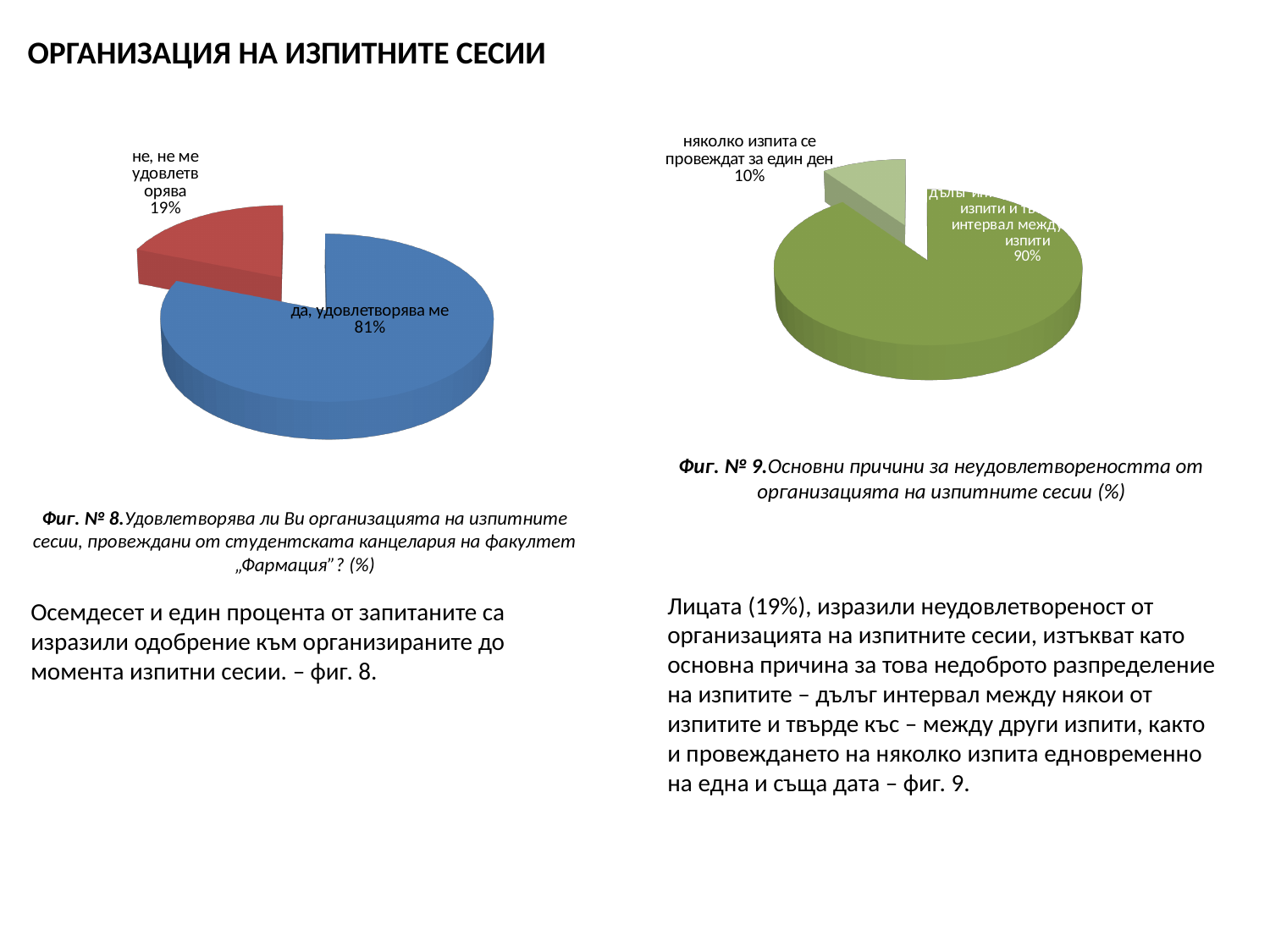
On the right chart (Фиг. № 9), is the share for "няколко изпита се провеждат за един ден" larger or smaller than the other slice? smaller On the right chart (Фиг. № 9), how many slices does the pie have? 2 On the right chart (Фиг. № 9), what is the share of the largest slice? 90% On the left chart (Фиг. № 8), how many slices does the pie have? 2 On the left chart (Фиг. № 8), what is the difference in percentage points between the "да, удовлетворява ме" and "не, не ме удовлетворява" slices? 62 On the left chart (Фиг. № 8), what percentage of respondents answered "да, удовлетворява ме"? 81% What type of chart is shown on the left (Фиг. № 8)? Pie chart On the left chart (Фиг. № 8), what colour is the "да, удовлетворява ме" slice? Blue On the left chart (Фиг. № 8), which answer has the largest share? да, удовлетворява ме On the left chart (Фиг. № 8), which answer has the smallest share? не, не ме удовлетворява On the left chart (Фиг. № 8), what percentage of respondents answered "не, не ме удовлетворява"? 19% On the right chart (Фиг. № 9), what percentage corresponds to "няколко изпита се провеждат за един ден"? 10%